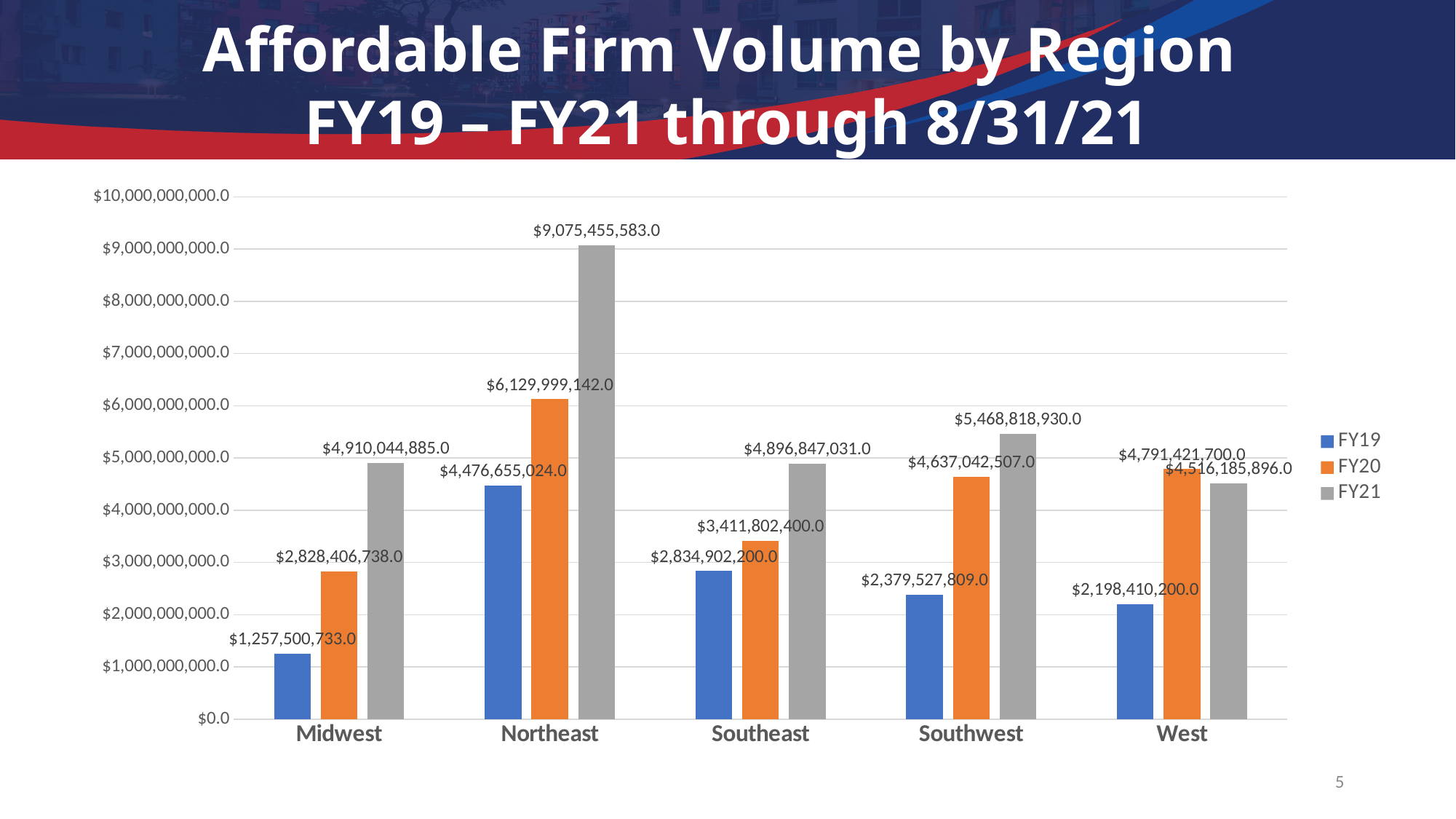
How many series does the legend list? 3 Is the FY20 value for the Southeast region greater or less than $4,000,000,000.0? less How many regions are shown on the x axis? 5 What is the difference between the FY21 and FY20 values for the Northeast region? $2,945,456,441.0 What is the FY20 value for the Southwest region? $4,637,042,507.0 Which region has the highest FY21 value? Northeast Which region has the lowest FY19 value? Midwest What kind of chart is shown on the slide? bar chart What is the FY21 value for the West region? $4,516,185,896.0 What is the FY21 value for the Northeast region? $9,075,455,583.0 For the West region, which is larger, the FY20 value or the FY21 value? FY20 What is the FY19 value for the Midwest region? $1,257,500,733.0